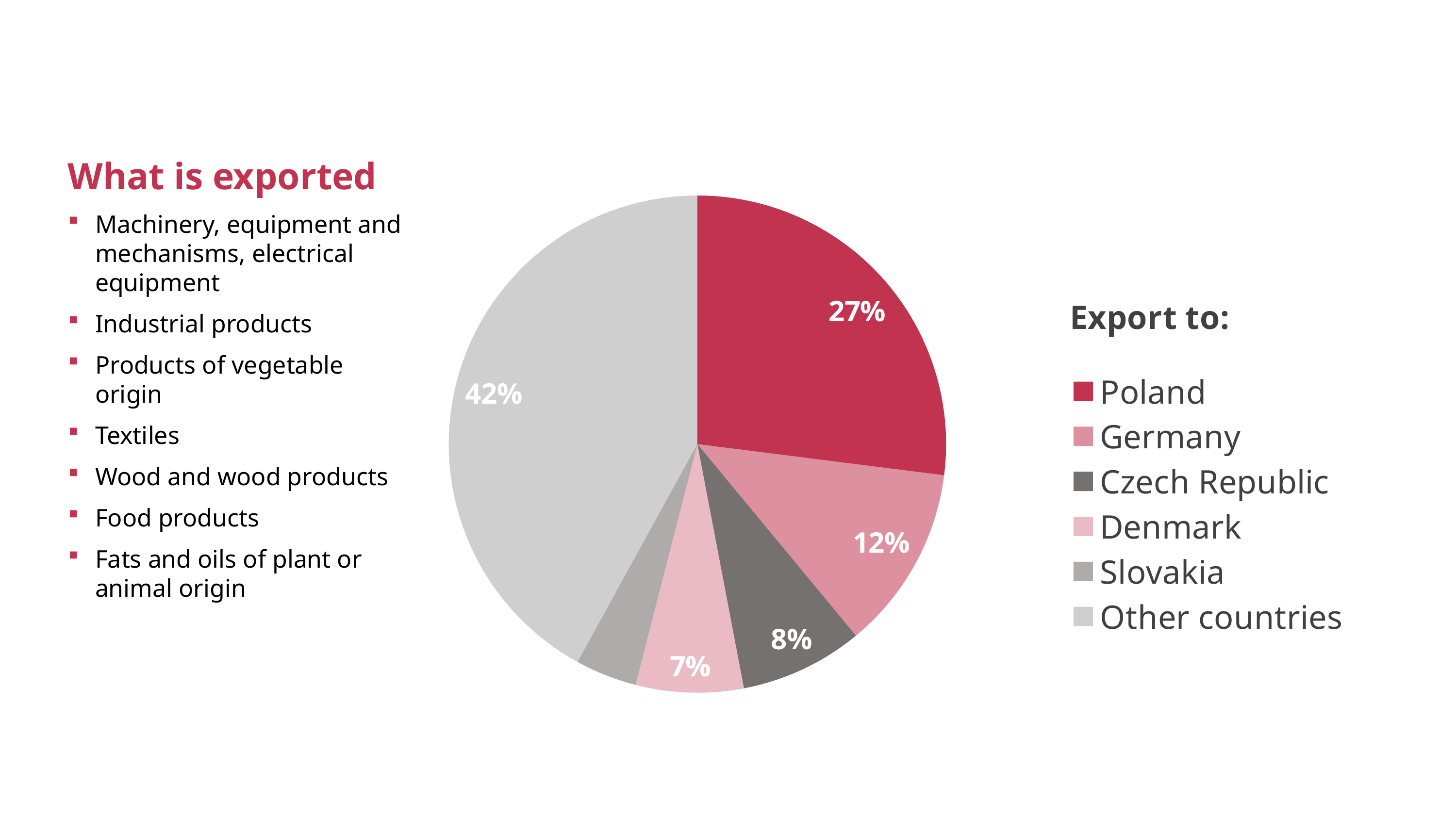
What percentage of exports goes to the Czech Republic? 8% What kind of chart is shown on the slide? pie chart What share of the pie is taken by Other countries? 42% How many entries does the legend list? 6 What is the heading above the legend of the pie chart? Export to: What percentage of exports goes to Poland? 27% Which category has the largest slice of the pie? Other countries What percentage of exports goes to Denmark? 7% Which country has the smallest slice of the pie? Slovakia What is the difference between the Poland and Germany shares? 15% Which is larger, the share for Germany or the share for the Czech Republic? Germany What percentage of exports goes to Germany? 12%